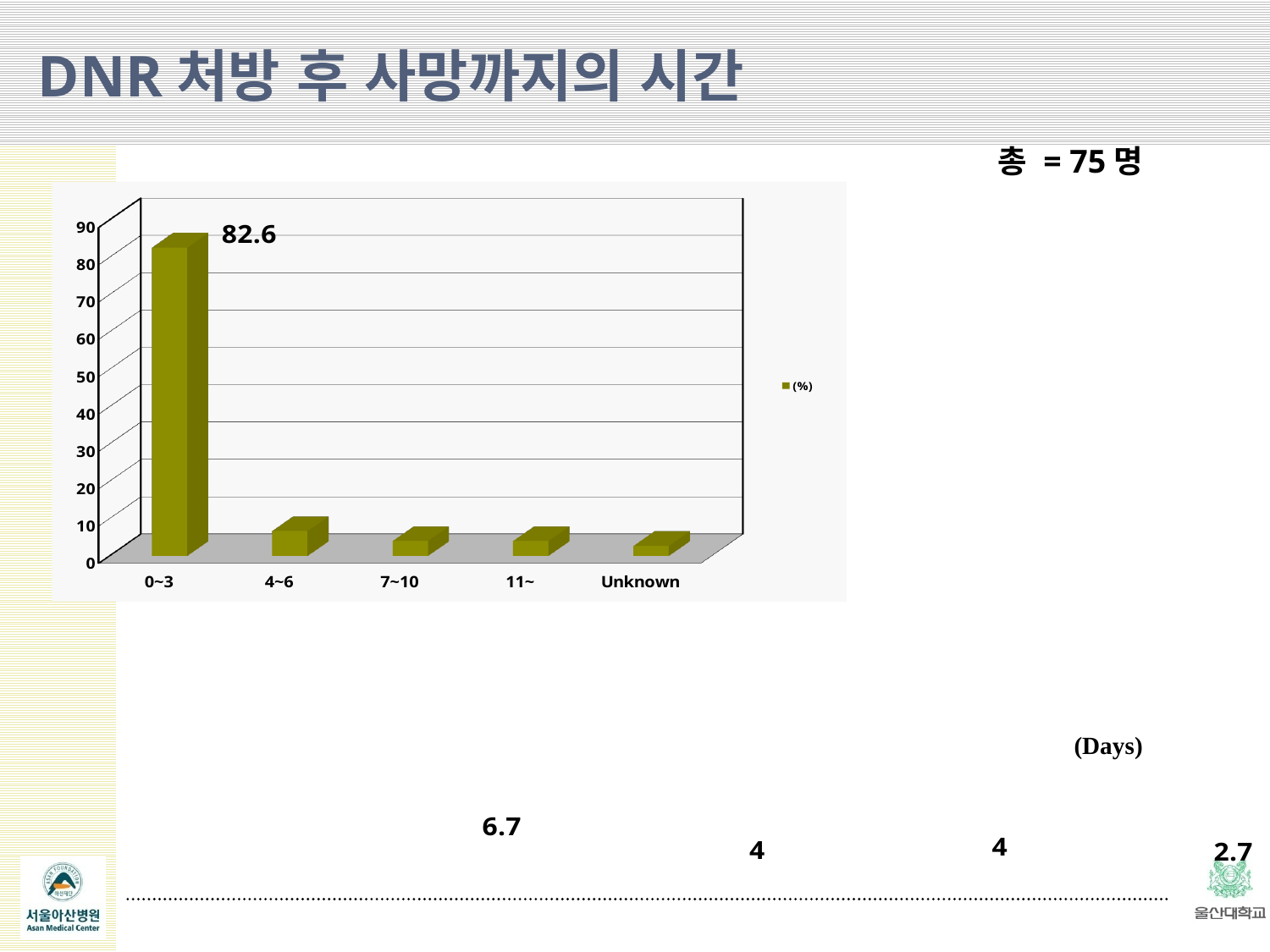
How many categories are shown on the x axis? 5 What is the legend entry for the series? (%) What is the value for the 0~3 category? 82.6 Which category has the lowest value? Unknown Which is larger, the value for 0~3 or the value for 4~6? 0~3 Is the value for Unknown greater or less than 10? less What kind of chart is shown on the slide? bar chart Is the value for 0~3 greater or less than 80? greater Which is larger, the value for 4~6 or the value for Unknown? 4~6 How many series does the legend list? 1 Which category has the highest value? 0~3 Is the value for 4~6 greater or less than 10? less